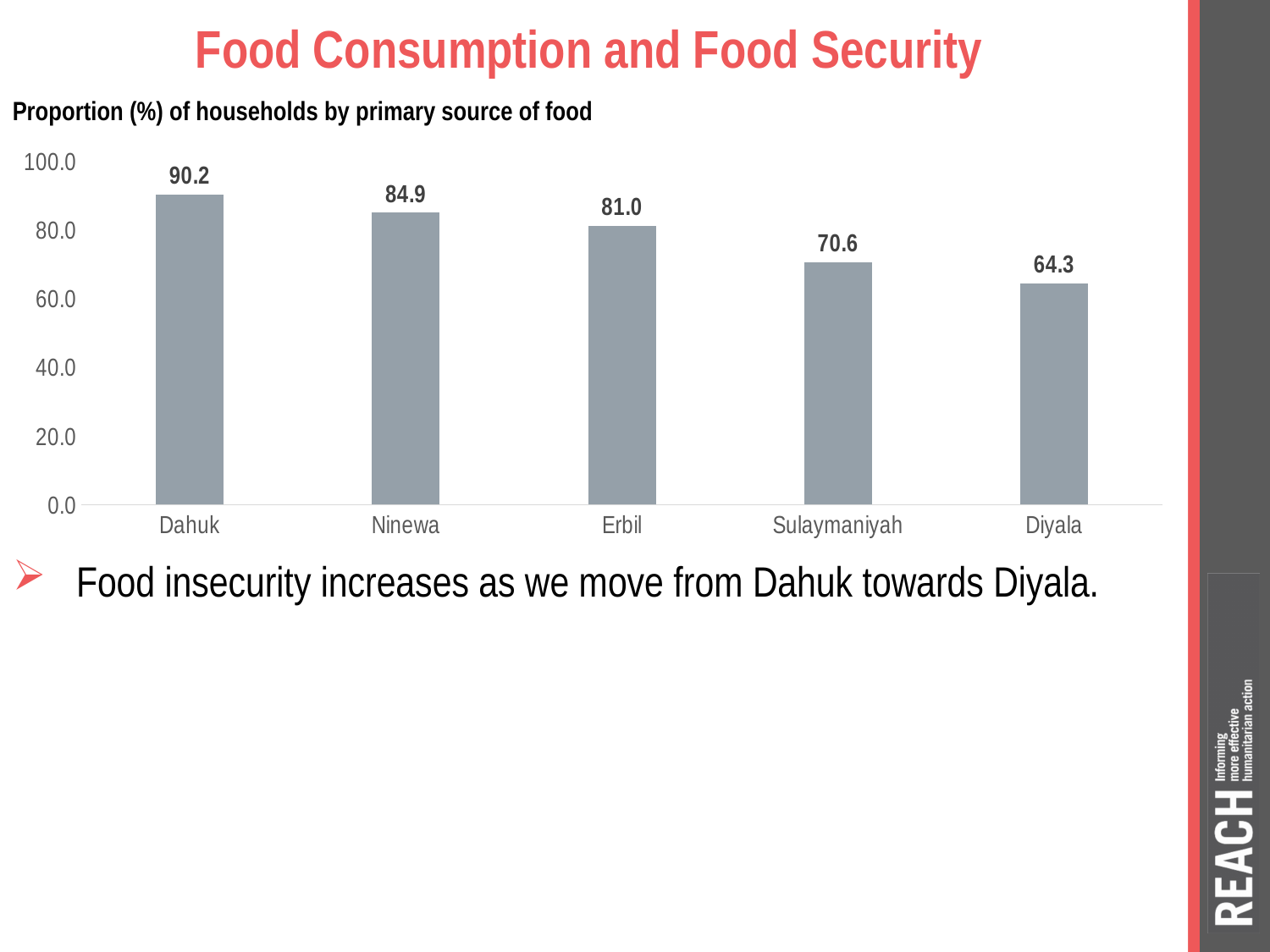
Do the values rise or fall moving from Dahuk to Diyala along the x axis? fall What is the difference between the values for Ninewa and Erbil? 3.9 Which category has the lowest value? Diyala What is the value for Sulaymaniyah? 70.6 What kind of chart is shown on the slide? bar chart What is the value for Dahuk? 90.2 Which is larger, the value for Erbil or the value for Sulaymaniyah? Erbil Is the value for Ninewa greater or less than 80.0? greater What is the value for Diyala? 64.3 How many categories are shown on the x axis? 5 Which category has the highest value? Dahuk What is the difference between the values for Dahuk and Diyala? 25.9